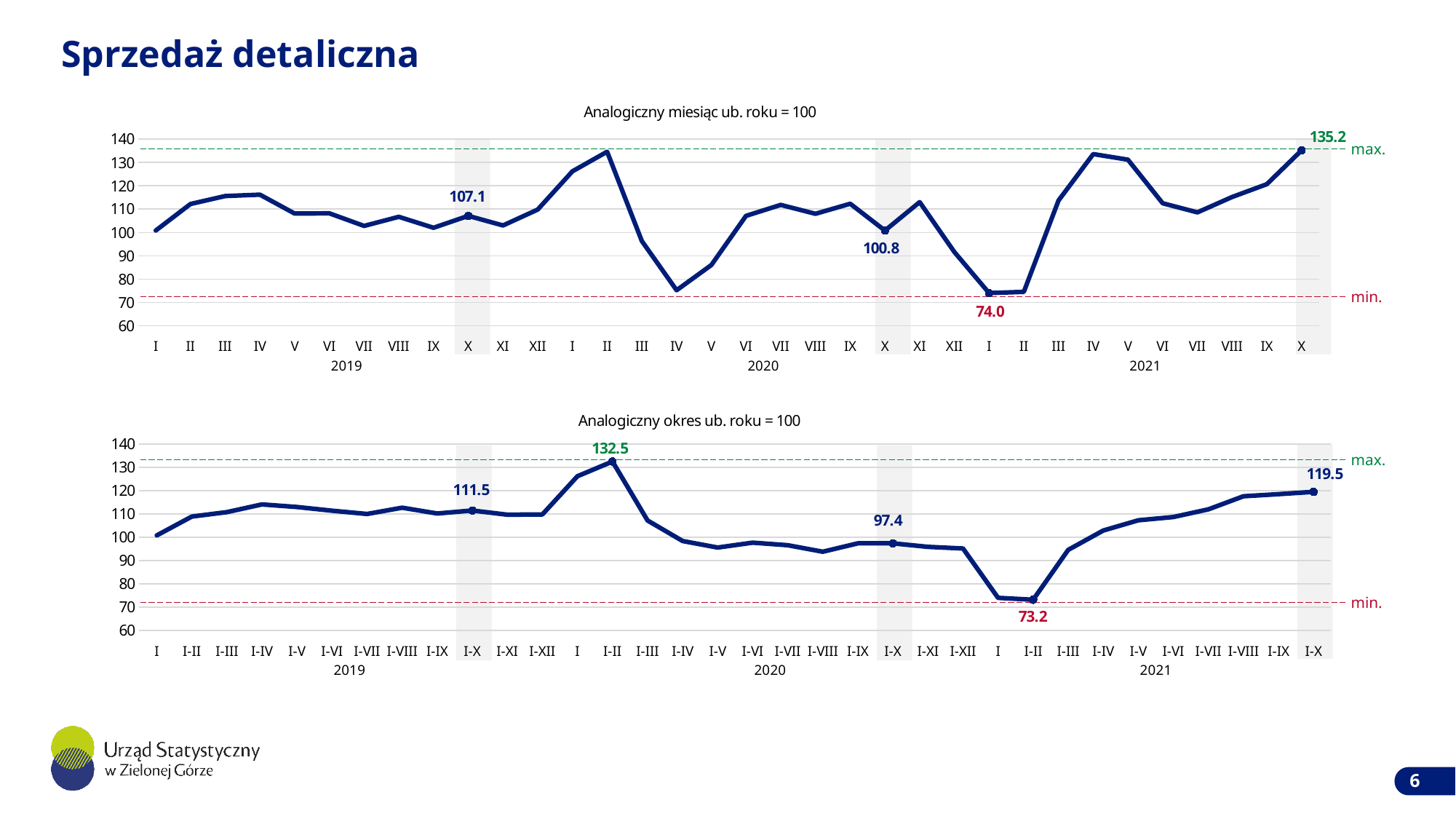
In the top chart (Analogiczny miesiąc ub. roku = 100), what is the value for X 2020? 100.8 In the top chart (Analogiczny miesiąc ub. roku = 100), is the value for IV 2020 greater or less than 80? less What kind of chart is the top chart (Analogiczny miesiąc ub. roku = 100)? line chart In the top chart (Analogiczny miesiąc ub. roku = 100), what is the value for X 2019? 107.1 In the bottom chart (Analogiczny okres ub. roku = 100), which is larger: the value for I-X 2019 or the value for I-X 2020? I-X 2019 In the bottom chart (Analogiczny okres ub. roku = 100), what is the value for I-II 2020? 132.5 In the top chart (Analogiczny miesiąc ub. roku = 100), which month has the lowest value? I 2021 In the bottom chart (Analogiczny okres ub. roku = 100), what is the value for I-X 2021? 119.5 In the top chart (Analogiczny miesiąc ub. roku = 100), what is the value for X 2021? 135.2 In the top chart (Analogiczny miesiąc ub. roku = 100), what is the difference between the value for X 2021 and the value for X 2020? 34.4 In the bottom chart (Analogiczny okres ub. roku = 100), which period has the lowest value? I-II 2021 In the bottom chart (Analogiczny okres ub. roku = 100), what is the difference between the value for I-X 2021 and the value for I-X 2020? 22.1